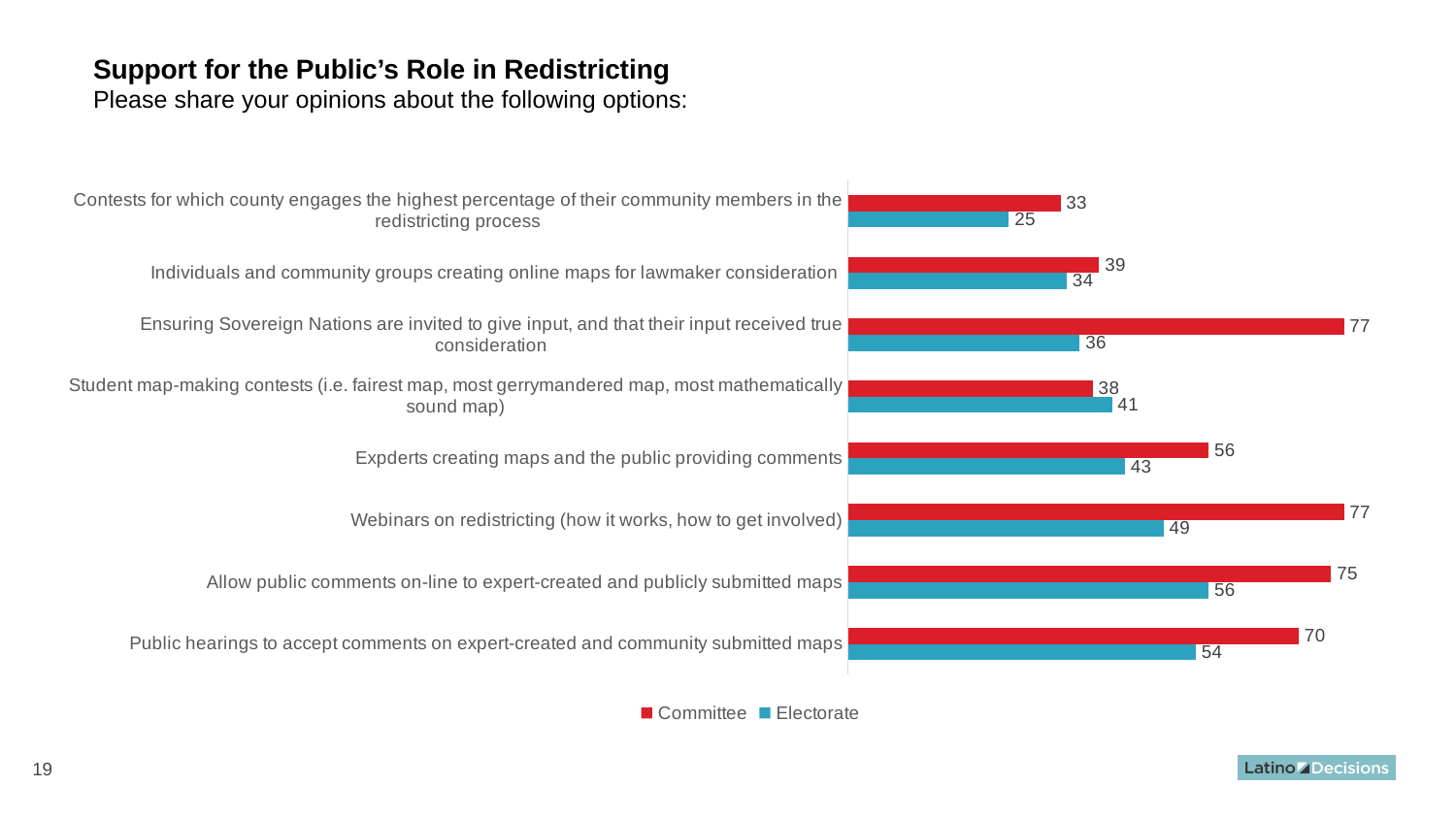
Which option has the lowest Committee value? Contests for which county engages the highest percentage of their community members in the redistricting process Which colour represents the Electorate series? Blue What is the Committee value for "Webinars on redistricting (how it works, how to get involved)"? 77 How many series does the legend list? 2 How many options (categories) are shown in the chart? 8 For "Allow public comments on-line to expert-created and publicly submitted maps", which is larger, the Committee value or the Electorate value? Committee What kind of chart is shown on the slide? Bar chart What is the difference between the Committee and Electorate values for "Ensuring Sovereign Nations are invited to give input, and that their input received true consideration"? 41 Which option has the highest Electorate value? Allow public comments on-line to expert-created and publicly submitted maps What is the Electorate value for "Student map-making contests"? 41 What is the Electorate value for "Public hearings to accept comments on expert-created and community submitted maps"? 54 For "Student map-making contests", which is larger, the Committee value or the Electorate value? Electorate